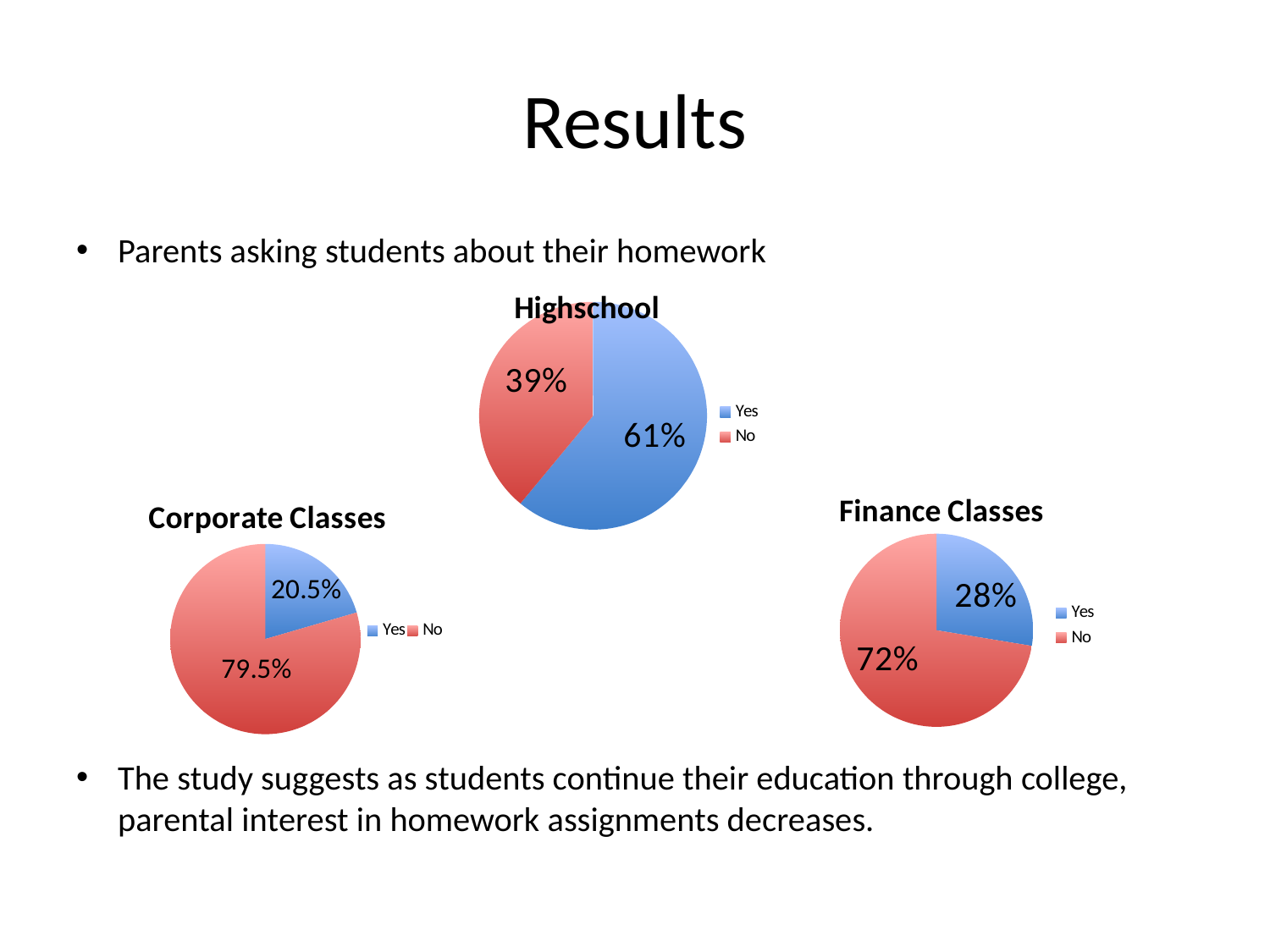
In the Highschool chart, what is the difference between the Yes and No shares? 22% In the Corporate Classes chart, which slice is the largest? No In the Highschool chart, which slice is larger, Yes or No? Yes How many entries does the legend of the Corporate Classes chart list? 2 In the Corporate Classes chart, what share of the pie is the Yes slice? 20.5% In the Highschool chart, what share of the pie is the Yes slice? 61% In the Finance Classes chart, what share of the pie is the Yes slice? 28% What kind of chart is the Finance Classes chart? Pie chart In the Finance Classes chart, which slice is the smallest? Yes